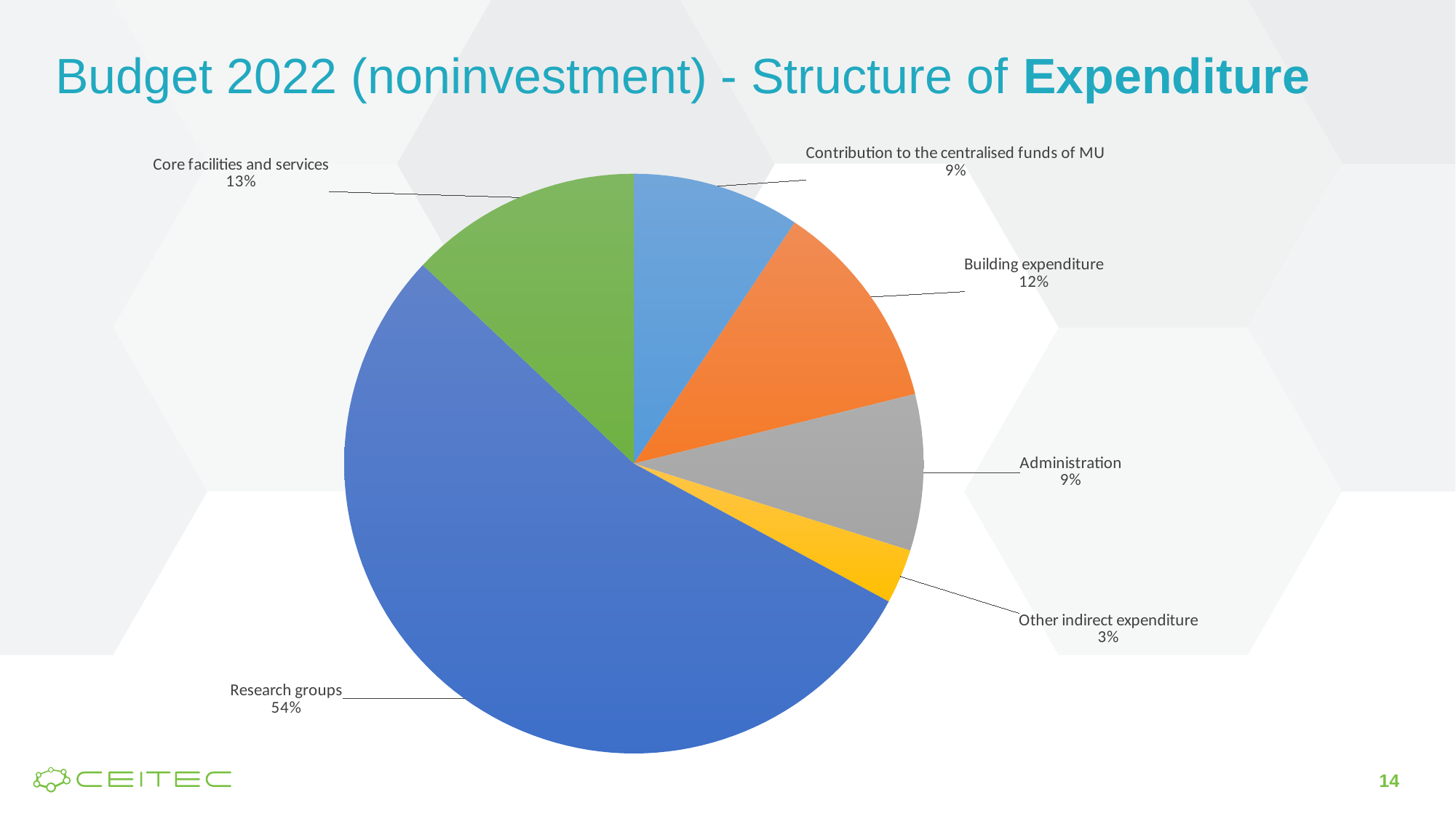
Which category has the smallest share of the pie? Other indirect expenditure What is the difference in percentage points between Research groups and Core facilities and services? 41 What percentage is shown for Building expenditure? 12% What percentage is shown for Other indirect expenditure? 3% What is the title of the slide containing the chart? Budget 2022 (noninvestment) - Structure of Expenditure Which is larger, Building expenditure or Administration? Building expenditure Which category has the largest share of the pie? Research groups How many categories are shown in the pie chart? 6 What percentage is shown for Core facilities and services? 13% What share of expenditure goes to Research groups? 54% What percentage is shown for Contribution to the centralised funds of MU? 9% What kind of chart is shown on the slide? pie chart